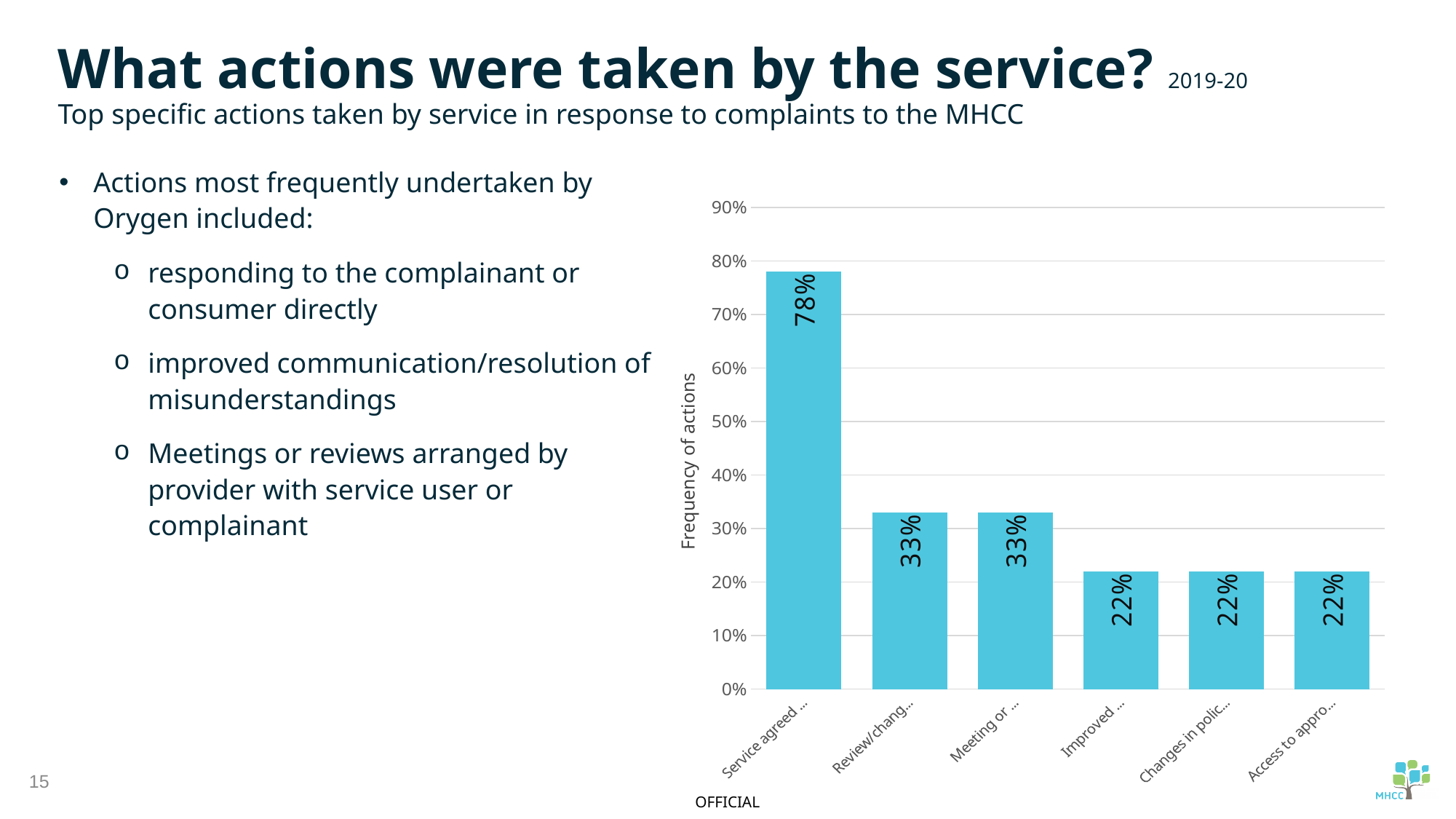
Which is larger: the value for the category beginning "Meeting or" or the value for the category beginning "Improved"? Meeting or ... What type of chart is shown on the slide? bar chart Which category has the highest value in the chart? Service agreed ... (the leftmost bar) What is the value of the bar for the category beginning "Changes in polic"? 22% What is the difference between the value for the category beginning "Review/chang" and the category beginning "Improved"? 11% How many bars are plotted in the chart? 6 What is the value of the bar for the category beginning "Review/chang"? 33% What is the value of the leftmost bar (the category beginning "Service agreed")? 78% What is the value of the rightmost bar (the category beginning "Access to appro")? 22% What is the label on the vertical axis of the chart? Frequency of actions Is the value of the leftmost bar greater or less than 70%? greater What is the difference between the value of the leftmost bar (78%) and the bar for the category beginning "Meeting or" (33%)? 45%